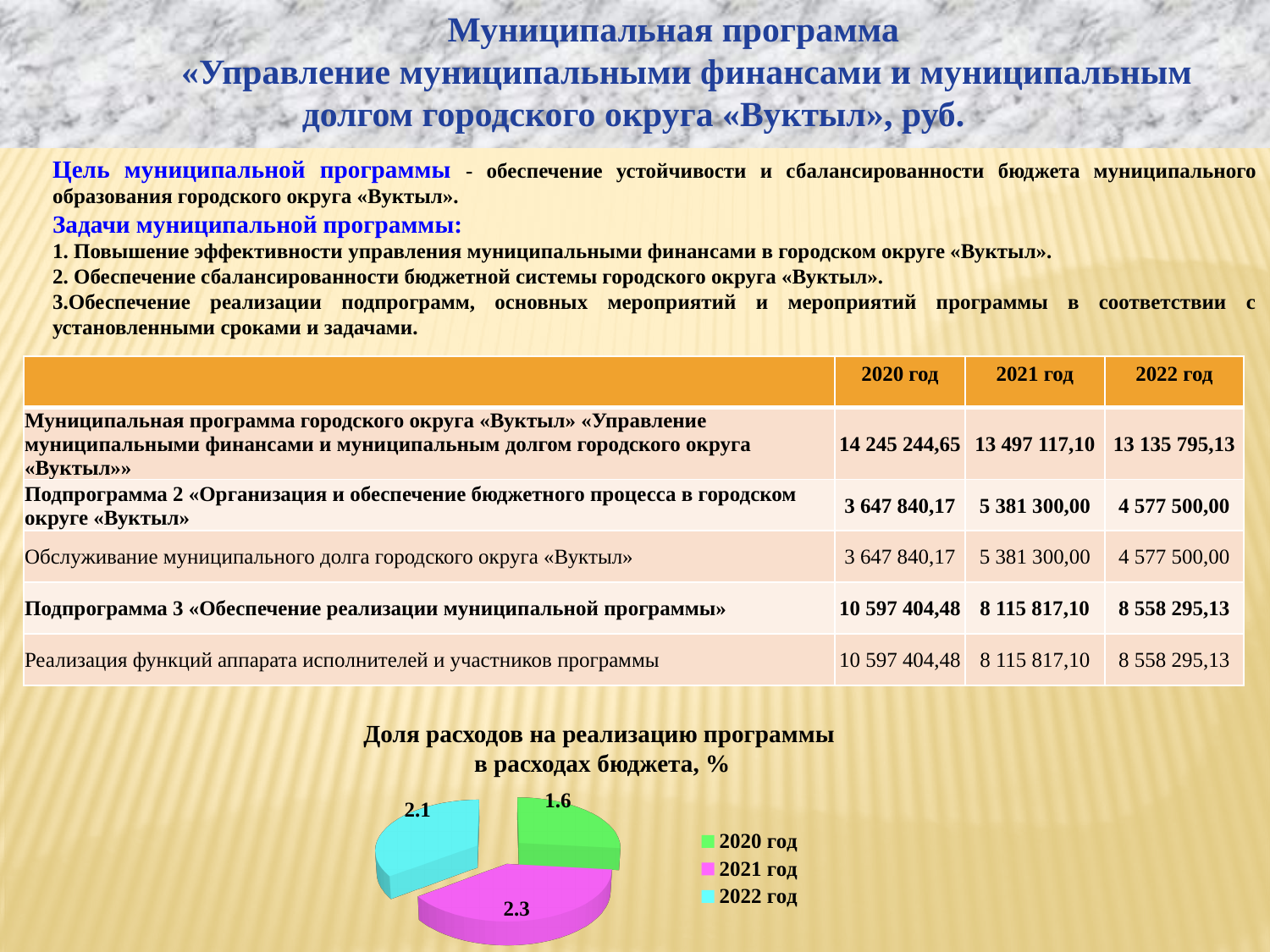
What is the title of the pie chart? Доля расходов на реализацию программы в расходах бюджета, % What type of chart is shown at the bottom of the slide? pie chart How many entries does the legend of the pie chart list? 3 In the pie chart, what is the value for 2020 год? 1.6 How many slices does the pie chart have? 3 In the pie chart, what is the value for 2021 год? 2.3 In the pie chart, what is the value for 2022 год? 2.1 Which year has the smallest slice in the pie chart? 2020 год In the pie chart, what is the difference between the values for 2021 год and 2020 год? 0.7 In the pie chart, what is the difference between the values for 2022 год and 2020 год? 0.5 In the pie chart, which is larger: the value for 2022 год or the value for 2020 год? 2022 год Which year has the largest slice in the pie chart? 2021 год